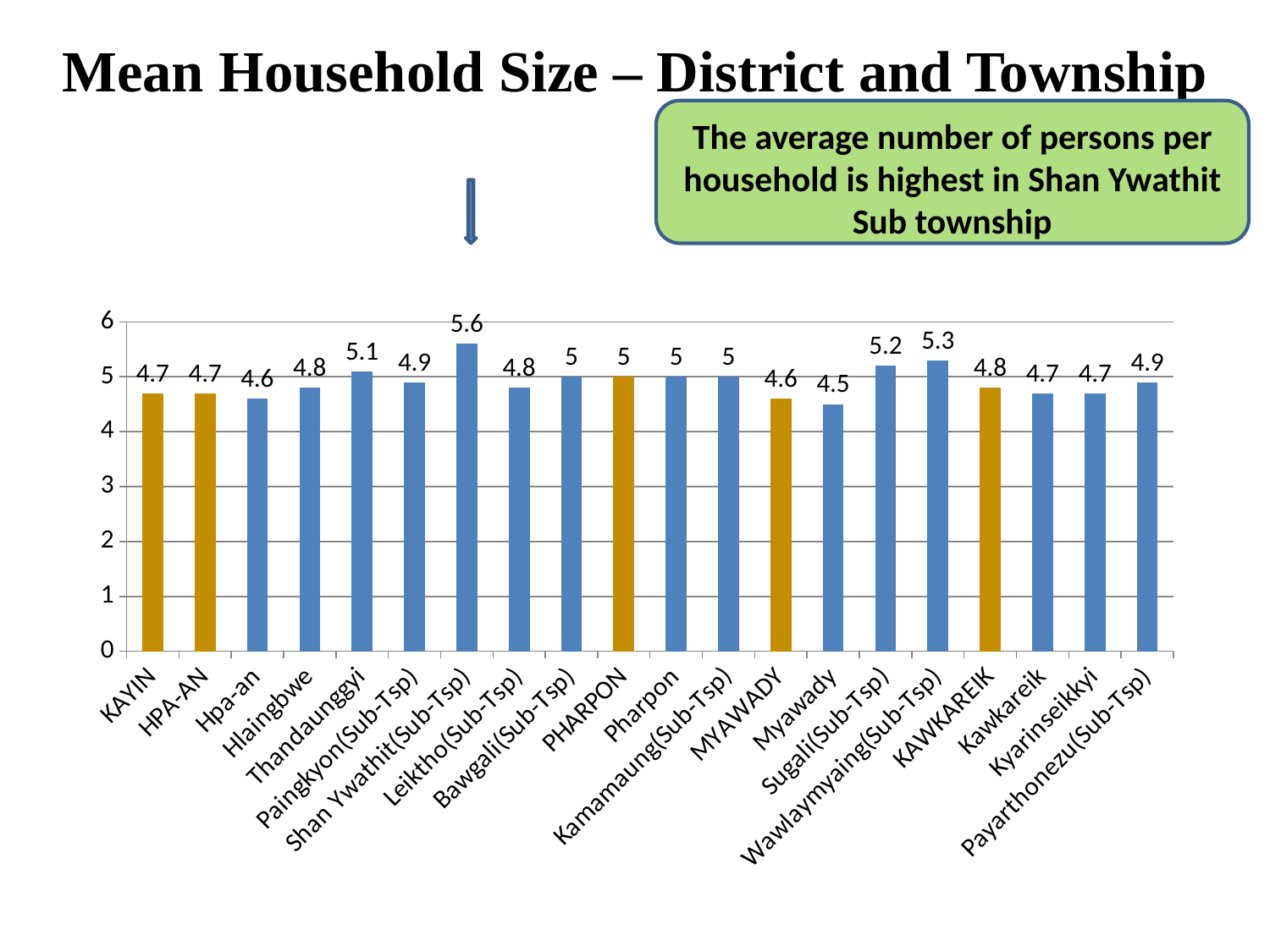
What is the mean household size for Shan Ywathit(Sub-Tsp)? 5.6 What is the difference between the mean household size of Shan Ywathit(Sub-Tsp) and Myawady? 1.1 What is the title of the slide containing the chart? Mean Household Size – District and Township Is the value for Paingkyon(Sub-Tsp) greater or less than 5? less What is the mean household size for Wawlaymyaing(Sub-Tsp)? 5.3 What is the mean household size for KAYIN? 4.7 What is the mean household size for Thandaunggyi? 5.1 How many categories are shown on the x axis of the chart? 20 What kind of chart is shown on the slide? Bar chart Which category has the lowest mean household size? Myawady Which category has the highest mean household size? Shan Ywathit(Sub-Tsp) Which has a larger mean household size, Sugali(Sub-Tsp) or Hlaingbwe? Sugali(Sub-Tsp)